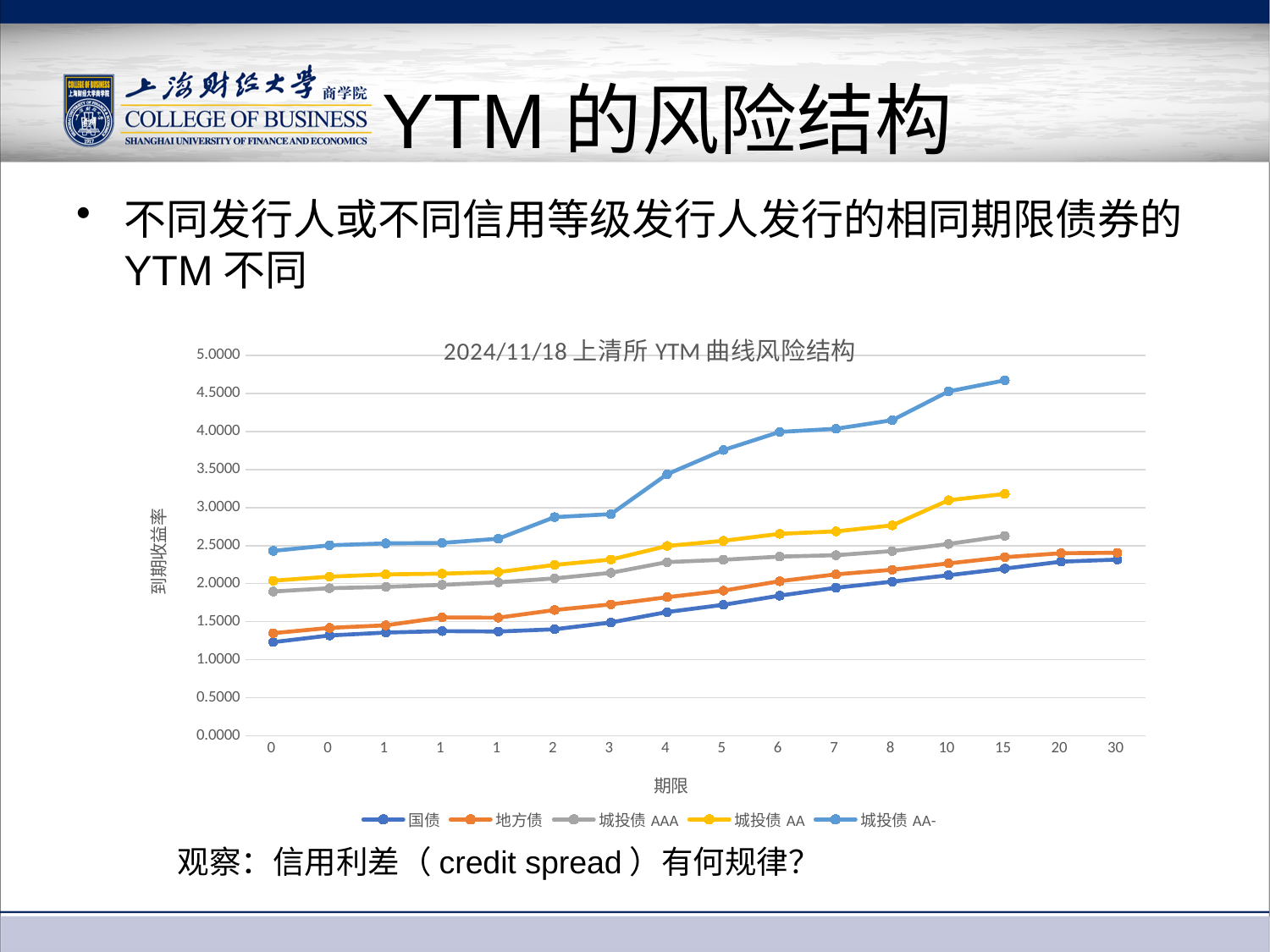
What is the title of the chart? 2024/11/18 上清所 YTM 曲线风险结构 Is the value for 城投债 AA- at 期限 15 greater or less than 4.5000? greater What is the label of the y axis? 到期收益率 How many series does the legend list? 5 What kind of chart is shown on the slide? line chart Which series has the highest values across the chart? 城投债 AA- Which series has the lowest values across the chart? 国债 How many points are marked along the x axis (期限)? 16 Do the values of the 城投债 AA- series rise or fall as 期限 increases? rise Is the value for 城投债 AA at 期限 10 greater or less than 3.0000? greater Is the value for 国债 at the first 期限 point (0) greater or less than 1.5000? less At 期限 15, which is larger: the value for 城投债 AA- or the value for 国债? 城投债 AA-